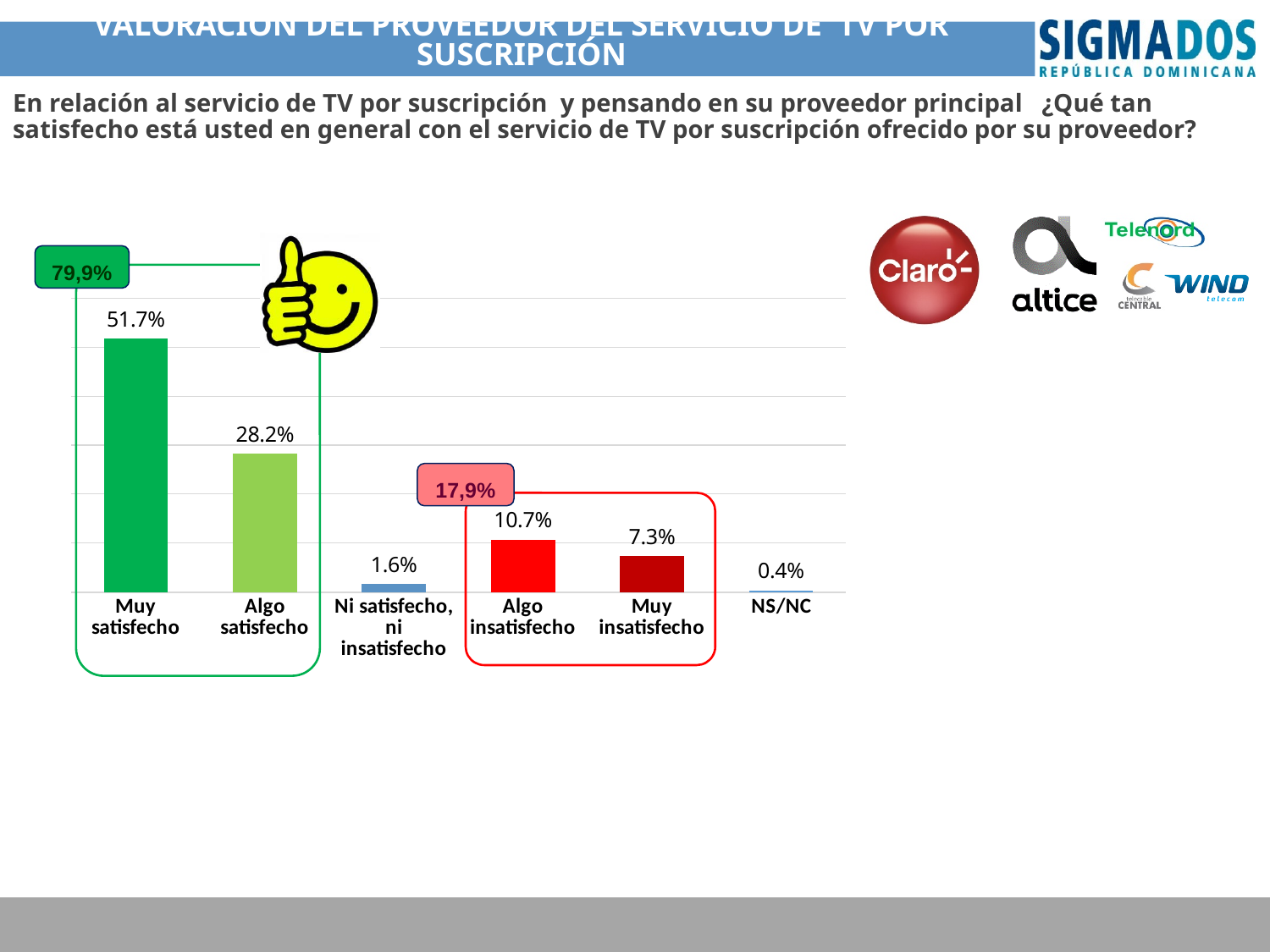
What is the value for Algo insatisfecho? 10.7% What is the value for Muy satisfecho? 51.7% What is the value for Algo satisfecho? 28.2% What is the value for Muy insatisfecho? 7.3% How many categories are shown on the x axis? 6 What is the difference between Muy satisfecho and Algo satisfecho? 23.5% What is the value for NS/NC? 0.4% What kind of chart is shown on the slide? Bar chart Which category has the lowest value? NS/NC Which category has the highest value? Muy satisfecho Which is larger, Algo insatisfecho or Muy insatisfecho? Algo insatisfecho What is the value for Ni satisfecho, ni insatisfecho? 1.6%